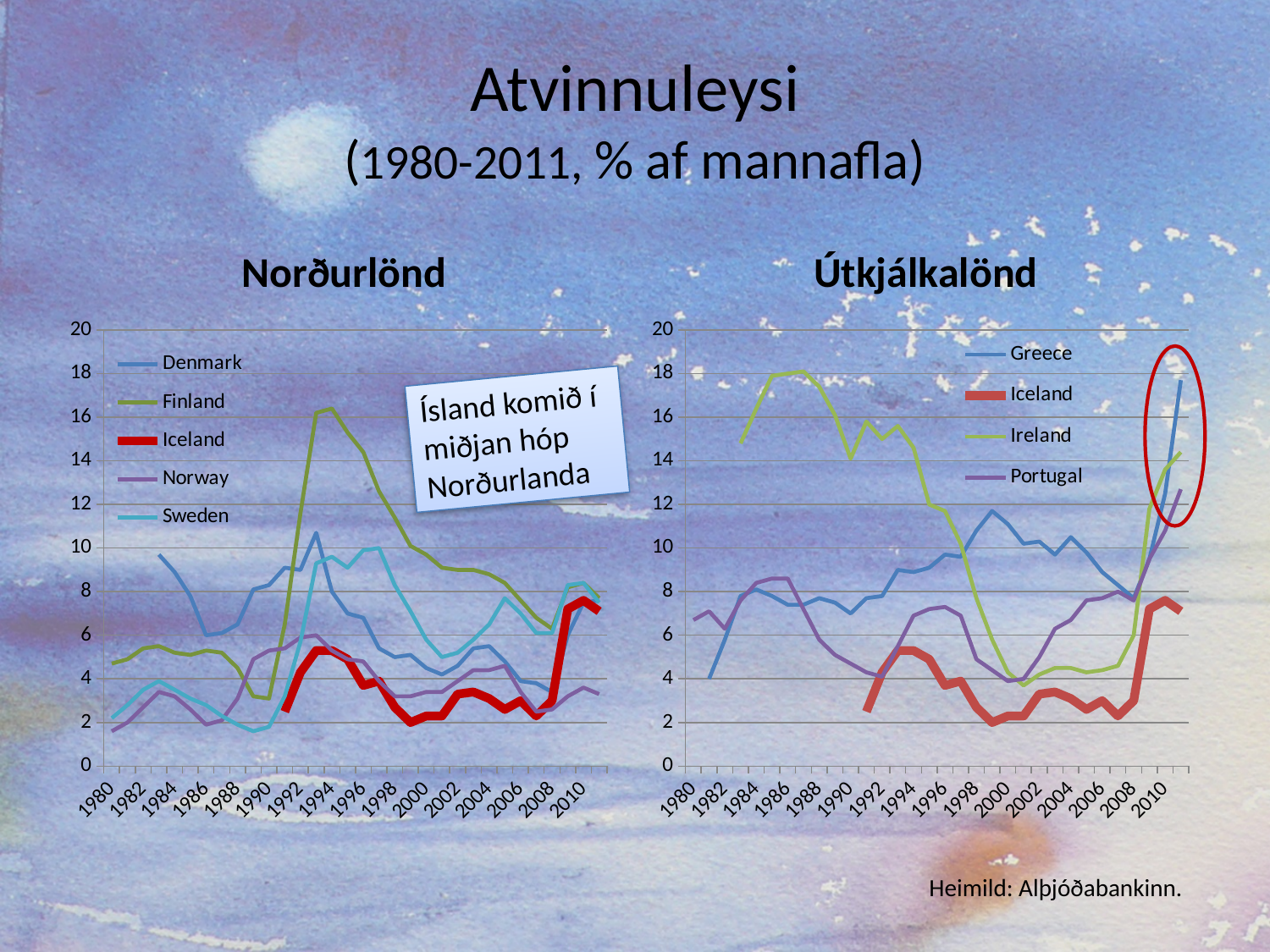
In the Norðurlönd chart, which country reaches the highest unemployment rate at any point? Finland In the Norðurlönd chart, which is larger in 1994: Finland or Norway? Finland In the Útkjálkalönd chart, which country reaches the highest unemployment rate at any point? Ireland In the Útkjálkalönd chart, is the value for Greece in 2011 greater or less than 16? greater How many series does the legend of the Norðurlönd chart list? 5 In the Útkjálkalönd chart, does the Iceland line rise or fall between 2008 and 2010? rise In the Norðurlönd chart, is the value for Finland in 1994 greater or less than 14? greater Which country's line is drawn thick and red in both charts? Iceland What kind of chart is the Norðurlönd chart on the left? line chart In the Útkjálkalönd chart, is the value for Ireland in 1986 greater or less than 16? greater How many series does the legend of the Útkjálkalönd chart list? 4